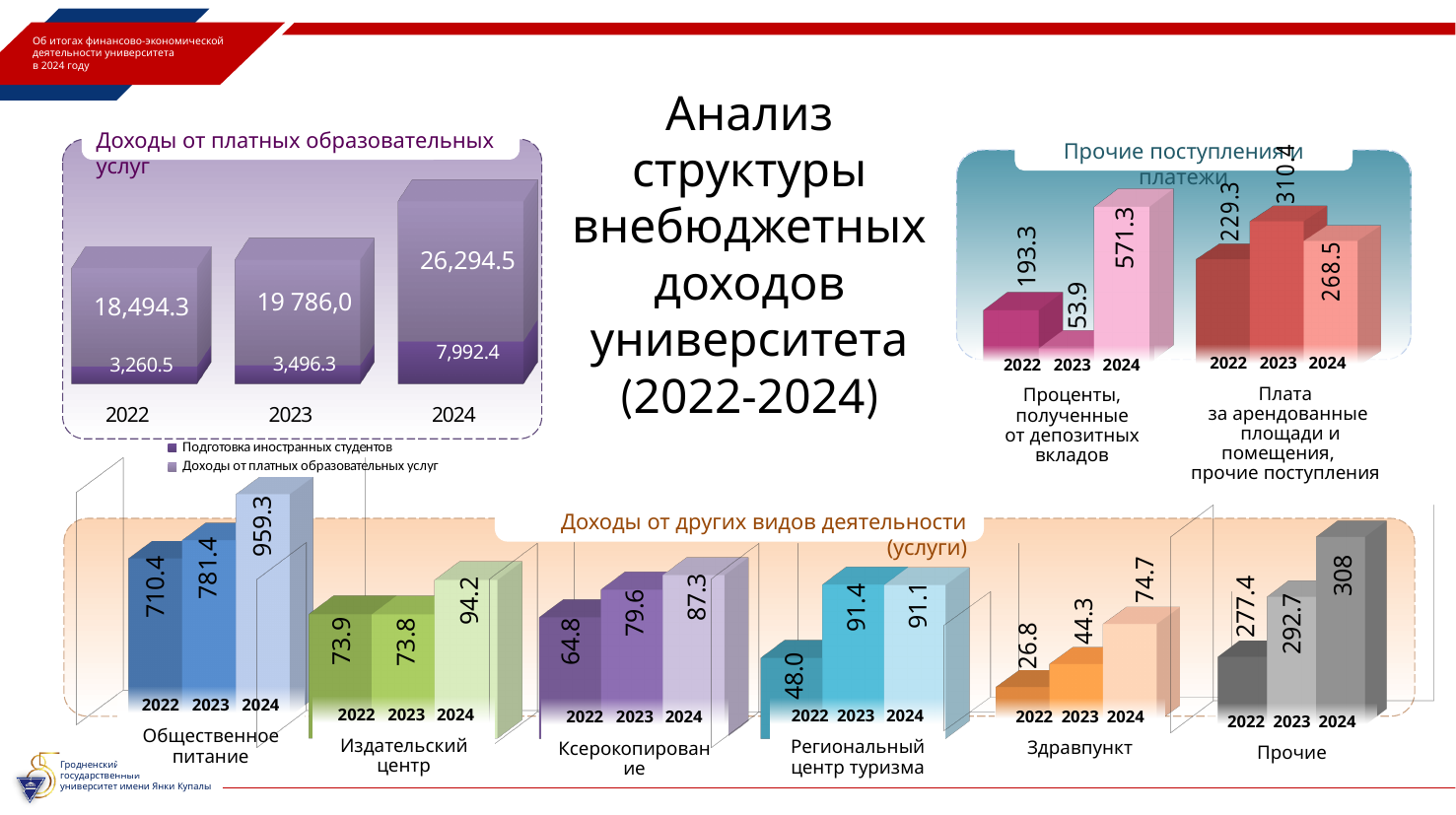
On the chart 'Доходы от других видов деятельности (услуги)', do the values for 'Здравпункт' rise or fall from 2022 to 2024? rise On the chart 'Доходы от других видов деятельности (услуги)', which is larger in 2024: 'Ксерокопирование' or 'Издательский центр'? Издательский центр On the chart 'Прочие поступления и платежи', which year has the highest value for 'Плата за арендованные площади и помещения, прочие поступления'? 2023 How many series does the legend of the chart 'Доходы от платных образовательных услуг' list? 2 On the chart 'Прочие поступления и платежи', what is the value for 'Проценты, полученные от депозитных вкладов' in 2024? 571.3 What kind of chart is 'Доходы от других видов деятельности (услуги)'? bar chart On the chart 'Доходы от платных образовательных услуг', what is the total of the stacked bar for 2022? 21,754.8 On the chart 'Доходы от других видов деятельности (услуги)', what is the value for 'Общественное питание' in 2024? 959.3 On the chart 'Прочие поступления и платежи', what is the difference between the 2024 and 2022 values for 'Проценты, полученные от депозитных вкладов'? 378.0 How many activity categories are shown on the chart 'Доходы от других видов деятельности (услуги)'? 6 On the chart 'Доходы от платных образовательных услуг', what is the value for 'Подготовка иностранных студентов' in 2024? 7,992.4 On the chart 'Доходы от платных образовательных услуг', what is the value of the upper segment ('Доходы от платных образовательных услуг') for 2023? 19 786,0